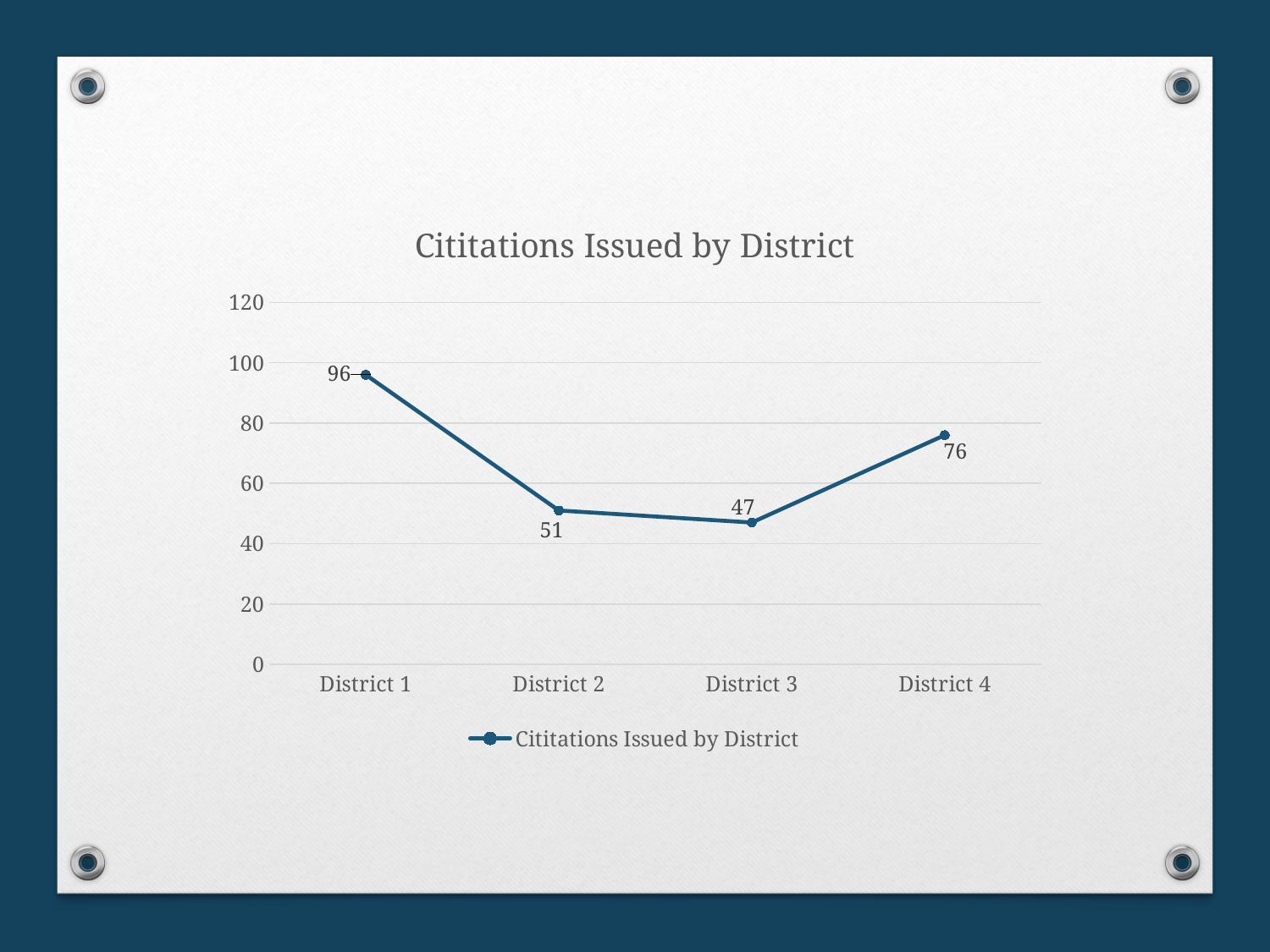
Which district has the highest number of citations issued? District 1 What is the title of the chart? Cititations Issued by District Which district has the lowest number of citations issued? District 3 What is the value for District 4? 76 What is the difference between the values for District 4 and District 3? 29 What is the value for District 1? 96 Is the value for District 4 greater or less than 60? greater How many districts are plotted on the chart? 4 What is the difference between the values for District 1 and District 2? 45 What kind of chart is shown on the slide? line chart Which is larger, the value for District 2 or District 4? District 4 What is the value for District 3? 47